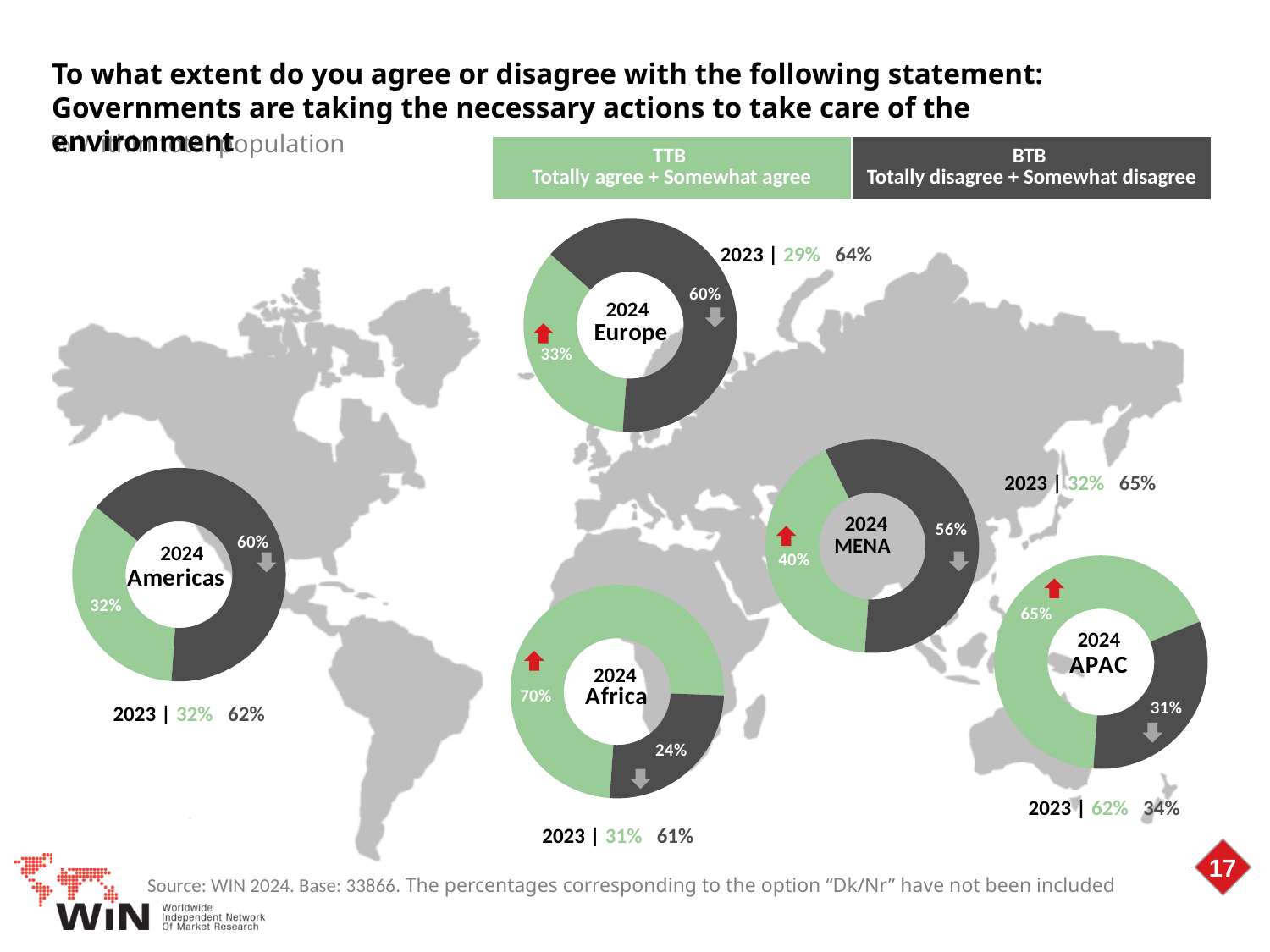
Which is larger in the 2024 MENA donut chart: the TTB value or the BTB value? BTB What colour represents TTB (Totally agree + Somewhat agree) in the donut charts? Green What kind of chart is used to show the 2024 results for each region? Donut (pie) chart In the 2024 MENA donut chart, what is the TTB value? 40% In the 2024 Africa donut chart, what is the difference between the TTB and BTB values? 46 percentage points In the 2024 APAC donut chart, what is the TTB value? 65% In the 2024 Americas donut chart, what is the BTB (Totally disagree + Somewhat disagree) value? 60% Across the five 2024 donut charts, which region has the highest TTB value? Africa In the 2024 Africa donut chart, what is the BTB value? 24% How many regional donut charts are shown on the slide? 5 Across the five 2024 donut charts, which region has the lowest BTB value? Africa In the 2024 Europe donut chart, what is the TTB (Totally agree + Somewhat agree) value? 33%